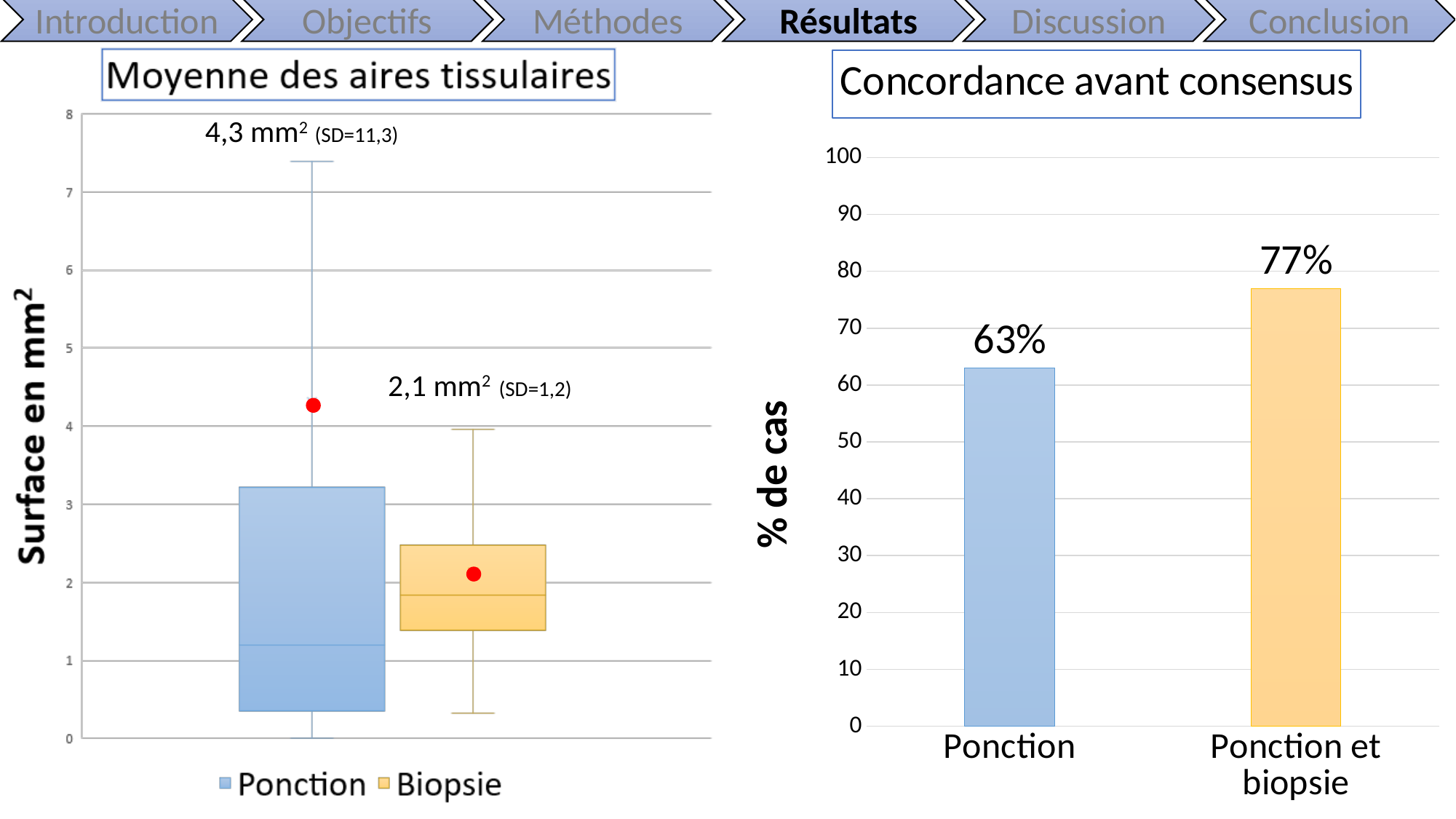
In the 'Concordance avant consensus' chart, what is the value for Ponction et biopsie? 77% In the 'Moyenne des aires tissulaires' chart, which group has the larger labelled mean, Ponction or Biopsie? Ponction What kind of chart is 'Concordance avant consensus'? Bar chart In the 'Moyenne des aires tissulaires' chart, how many series does the legend list? 2 In the 'Concordance avant consensus' chart, what is the value for Ponction? 63% In the 'Moyenne des aires tissulaires' chart, what is the SD given for Ponction? 11,3 In the 'Concordance avant consensus' chart, how many bars are plotted? 2 In the 'Concordance avant consensus' chart, which category has the highest value? Ponction et biopsie In the 'Moyenne des aires tissulaires' chart, what is the mean surface area labelled for Ponction? 4,3 mm² In the 'Concordance avant consensus' chart, what is the y-axis label? % de cas In the 'Concordance avant consensus' chart, what is the difference between Ponction et biopsie and Ponction? 14% In the 'Moyenne des aires tissulaires' chart, what is the mean surface area labelled for Biopsie? 2,1 mm²